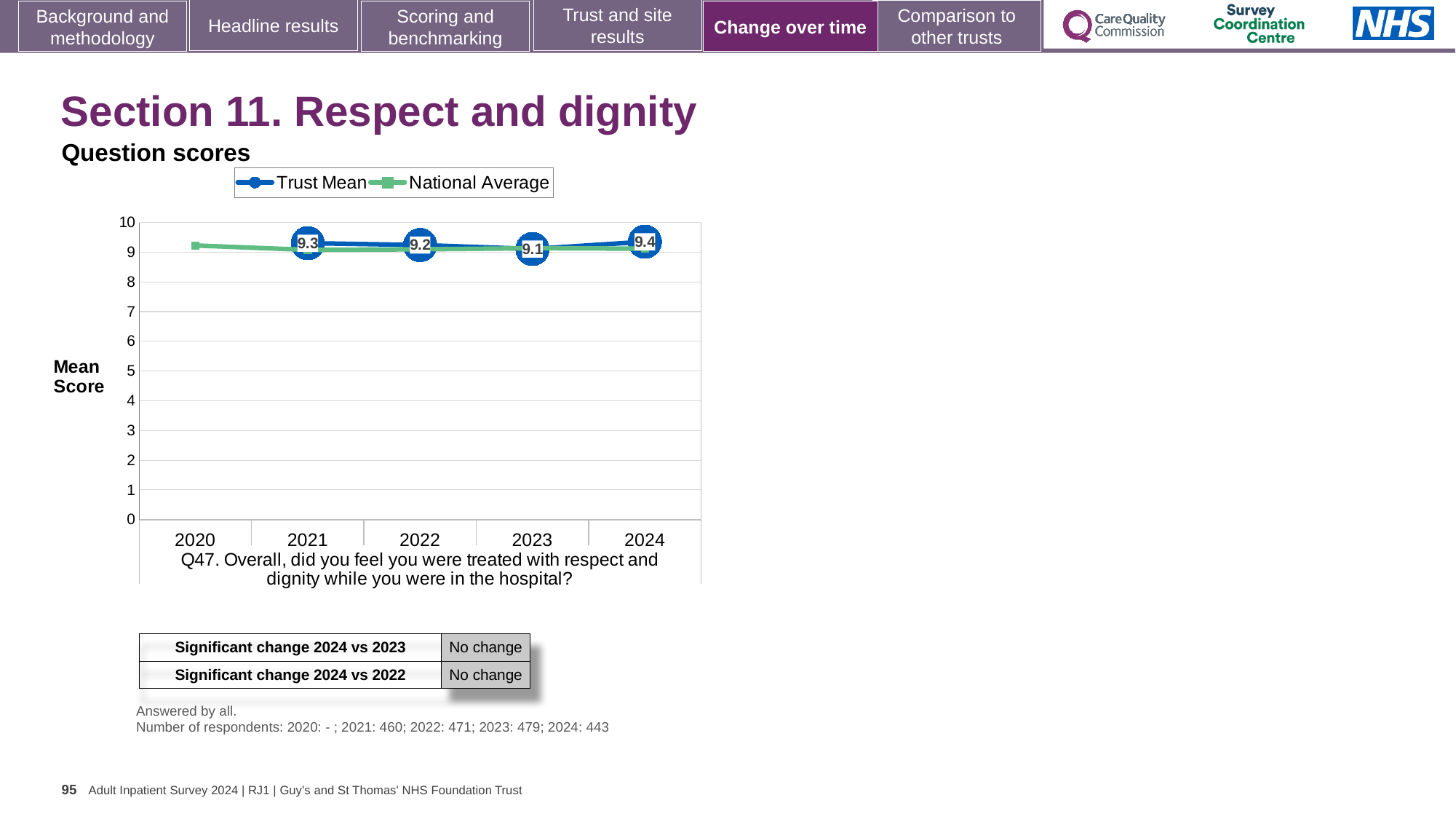
How many series does the legend list? 2 In which year is the Trust Mean score lowest? 2023 What is the Trust Mean score for 2021? 9.3 In which year is the Trust Mean score highest? 2024 What is the difference between the Trust Mean scores for 2024 and 2023? 0.3 Is the National Average value for 2020 greater or less than 5? greater How many years are shown on the x axis? 5 What is the difference between the Trust Mean scores for 2021 and 2022? 0.1 Which year has the larger Trust Mean score, 2021 or 2022? 2021 What is the Trust Mean score for 2023? 9.1 What kind of chart is shown on the slide? line chart What is the Trust Mean score for 2024? 9.4